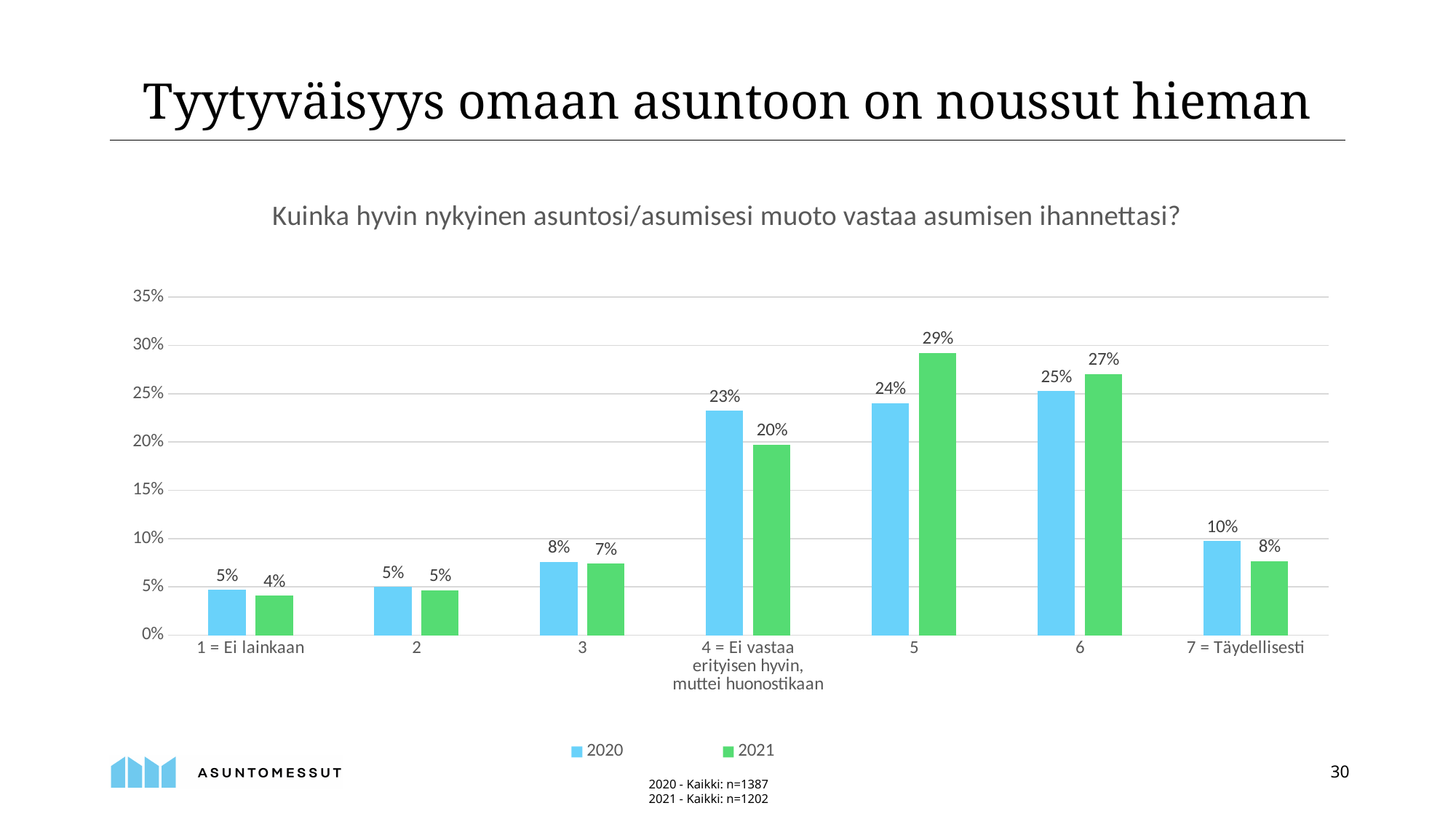
What is the 2020 value for "4 = Ei vastaa erityisen hyvin, muttei huonostikaan"? 23% What kind of chart is shown on the slide? Bar chart Which is larger for category 4: the 2020 value or the 2021 value? 2020 Which is larger for category 6: the 2020 value or the 2021 value? 2021 How many series does the legend list? 2 How many categories are shown on the x axis? 7 Which series is shown in green in the legend? 2021 Which category has the highest 2020 value? 6 What is the difference between the 2021 and 2020 values for category 5? 5 percentage points What is the 2021 value for "7 = Täydellisesti"? 8% What is the 2021 value for category 5? 29% Which category has the highest 2021 value? 5